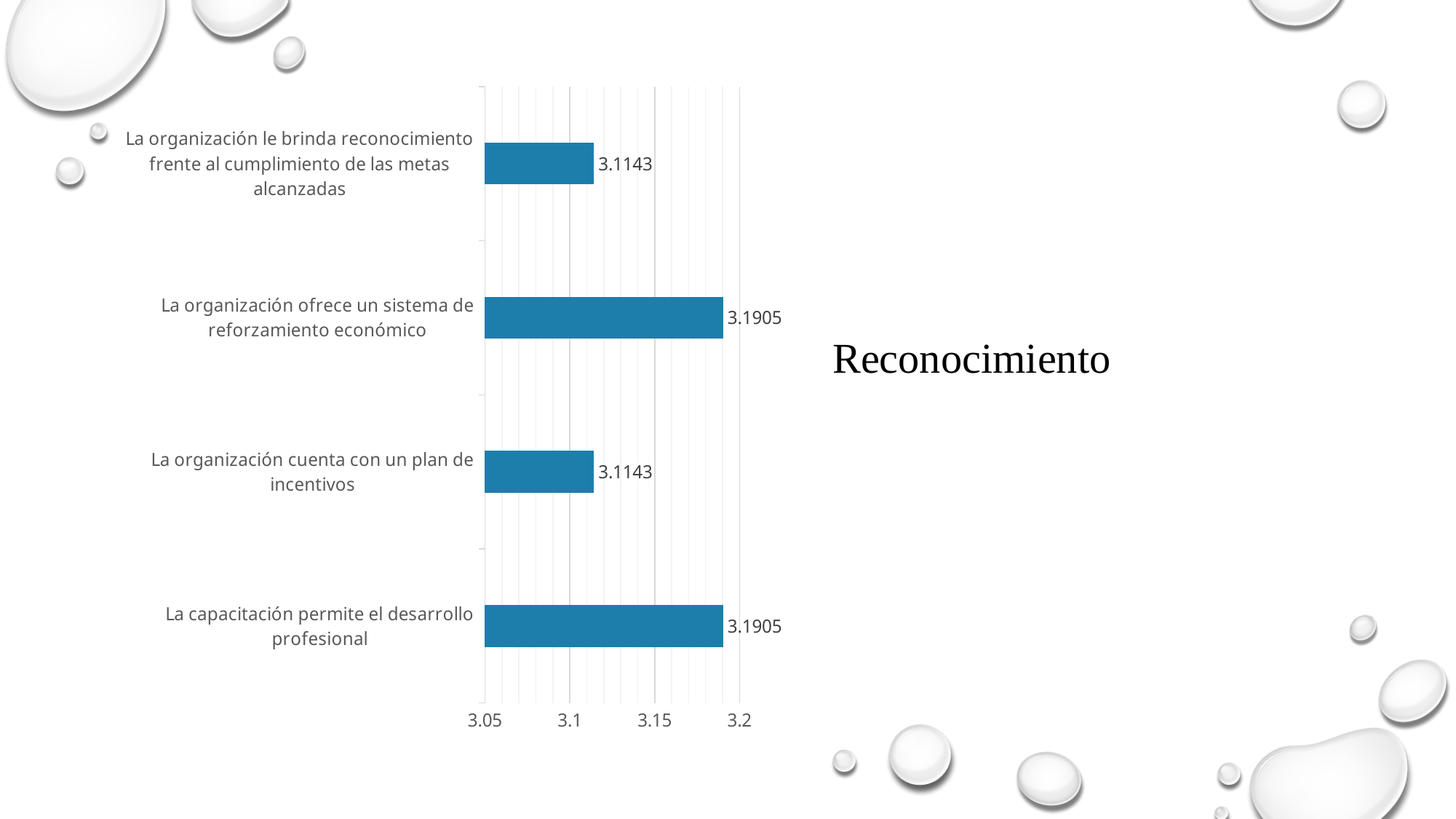
Is the value for "La organización cuenta con un plan de incentivos" greater or less than 3.1? greater What is the value for "La organización cuenta con un plan de incentivos"? 3.1143 What kind of chart is shown on the slide? Bar chart How many categories are shown in the chart? 4 What is the lowest value shown on the horizontal axis? 3.05 What is the title shown next to the chart? Reconocimiento What is the value for "La organización le brinda reconocimiento frente al cumplimiento de las metas alcanzadas"? 3.1143 Which is larger: the value for "La organización ofrece un sistema de reforzamiento económico" or the value for "La organización cuenta con un plan de incentivos"? La organización ofrece un sistema de reforzamiento económico What is the difference between the value for "La capacitación permite el desarrollo profesional" and the value for "La organización le brinda reconocimiento frente al cumplimiento de las metas alcanzadas"? 0.0762 What is the value for "La organización ofrece un sistema de reforzamiento económico"? 3.1905 Is the value for "La capacitación permite el desarrollo profesional" greater or less than 3.2? less What is the value for "La capacitación permite el desarrollo profesional"? 3.1905